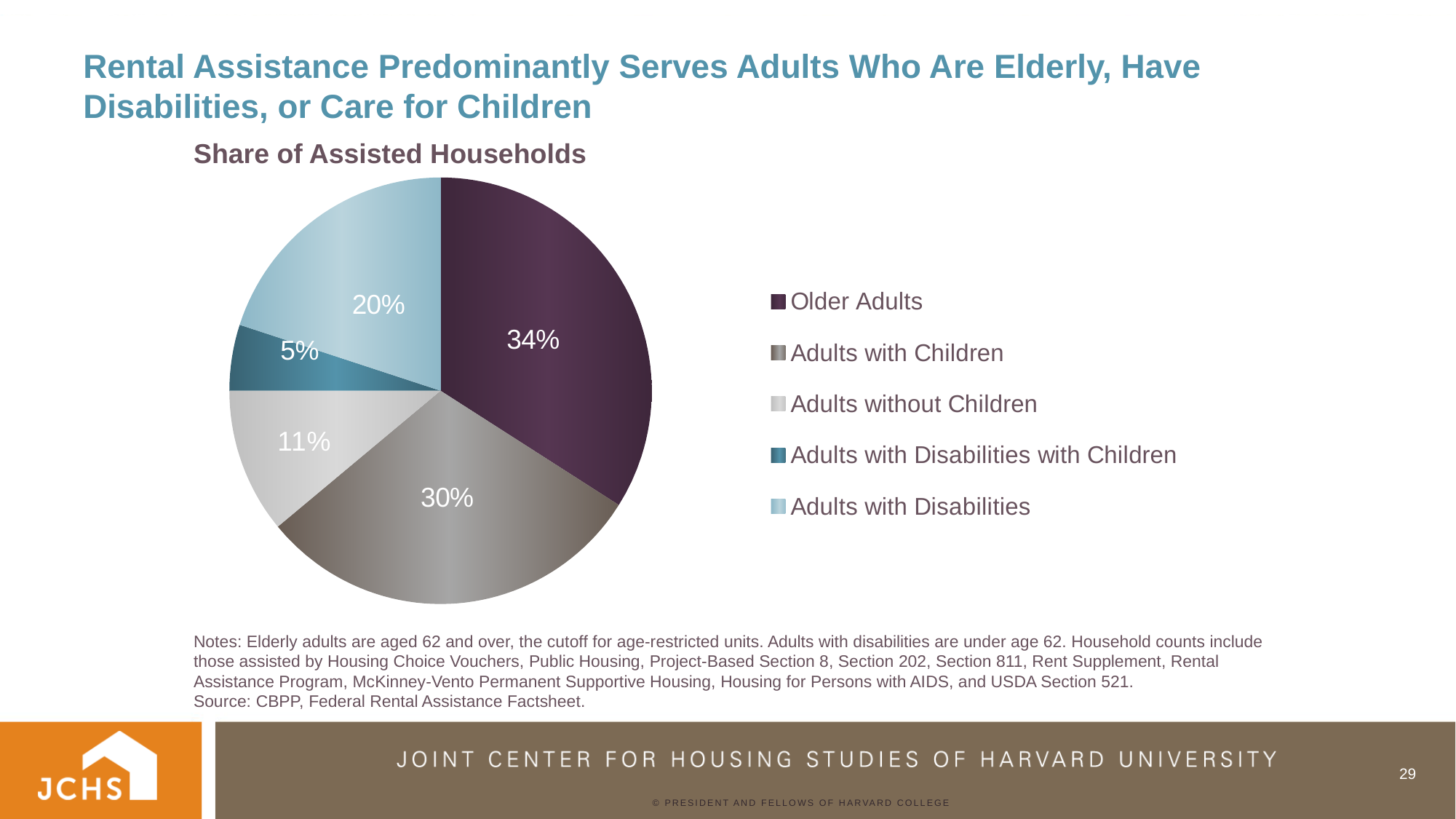
What share of assisted households are Adults without Children? 11% What share of assisted households are Adults with Disabilities with Children? 5% What share of assisted households are Adults with Disabilities? 20% What kind of chart is shown on the slide? Pie chart How many categories does the legend list? 5 Which category has the smallest share of assisted households? Adults with Disabilities with Children What share of assisted households are Older Adults? 34% What share of assisted households are Adults with Children? 30% Which is larger: the share for Adults with Disabilities or the share for Adults without Children? Adults with Disabilities What is the title of the chart? Share of Assisted Households Which category has the largest share of assisted households? Older Adults What is the difference in share between Older Adults and Adults with Children? 4 percentage points